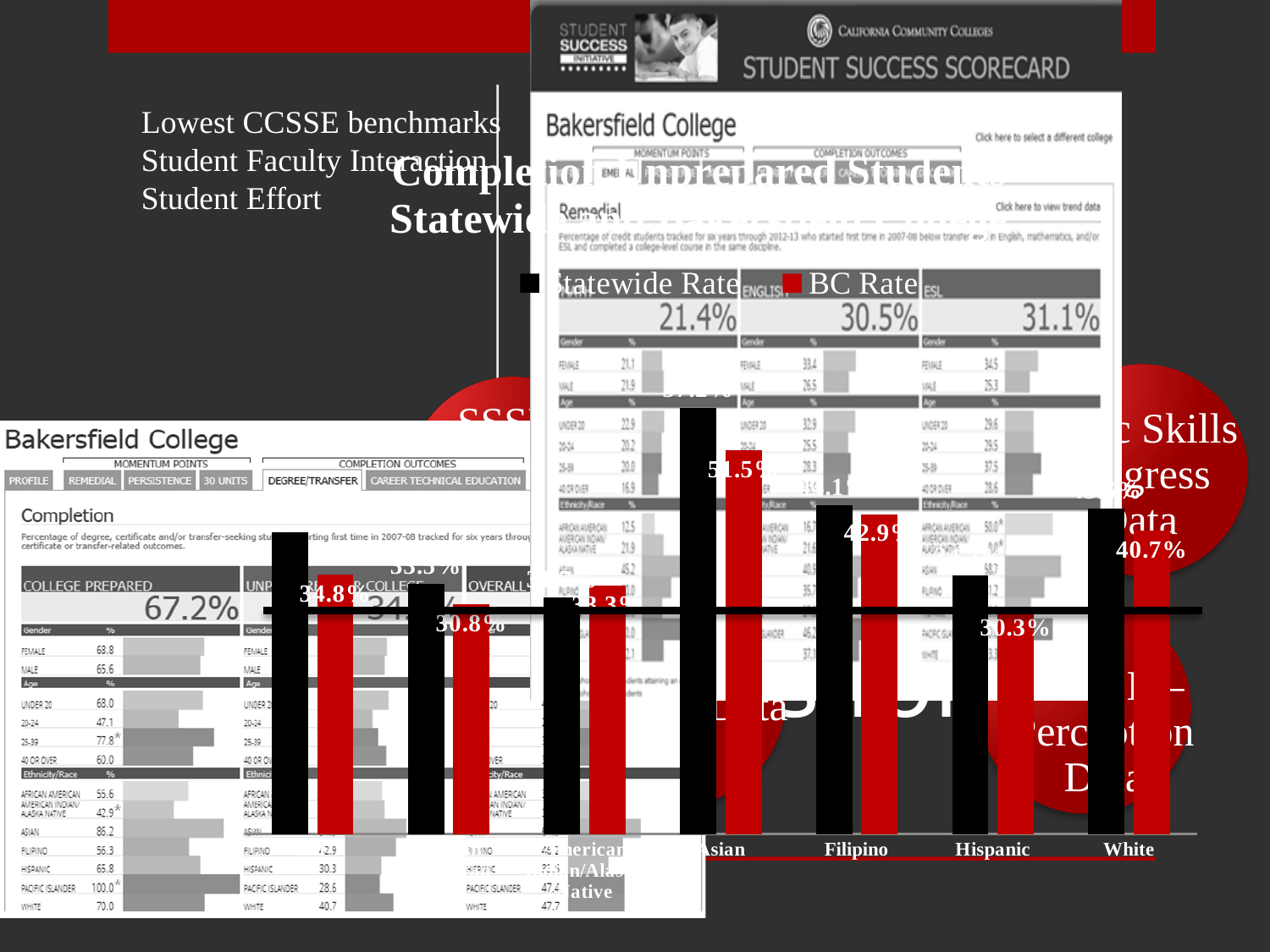
What is the difference between the BC Rate for White students and the BC Rate for Hispanic students? 10.4 percentage points Among Asian, Filipino, Hispanic and White students, which group has the lowest BC Rate? Hispanic For Asian students, which is larger, the Statewide Rate or the BC Rate? Statewide Rate What kind of chart is shown on the slide? bar chart What is the Statewide Rate for Asian students? 57.2% What is the difference between the Statewide Rate and the BC Rate for Asian students? 5.7 percentage points Which colour represents the BC Rate series in the chart? red What is the BC Rate for Hispanic students? 30.3% What is the BC Rate for Asian students? 51.5% How many series does the chart's legend list? 2 What are the two series named in the chart's legend? Statewide Rate and BC Rate What is the BC Rate for White students? 40.7%